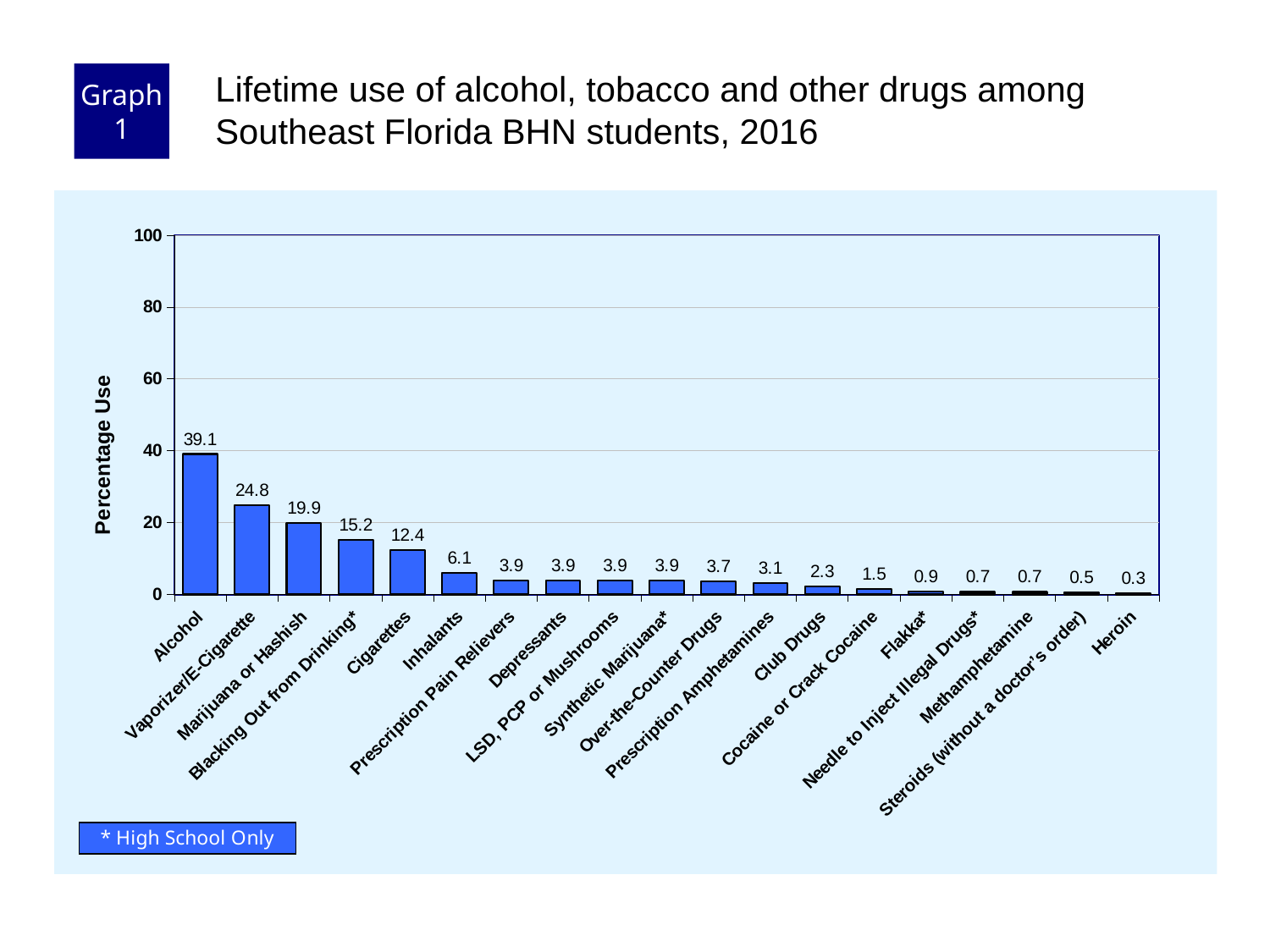
Which category has the lowest percentage use? Heroin What is the difference in percentage use between Alcohol and Vaporizer/E-Cigarette? 14.3 How many categories are shown on the x axis? 19 Which category has the highest percentage use? Alcohol What is the percentage use for Vaporizer/E-Cigarette? 24.8 Which has a higher percentage use, Marijuana or Hashish or Cigarettes? Marijuana or Hashish What kind of chart is shown on the slide? Bar chart What is the label of the y axis? Percentage Use What is the percentage use for Cigarettes? 12.4 Is the value for Alcohol greater or less than 40? less What is the percentage use for Alcohol? 39.1 What is the percentage use for Heroin? 0.3